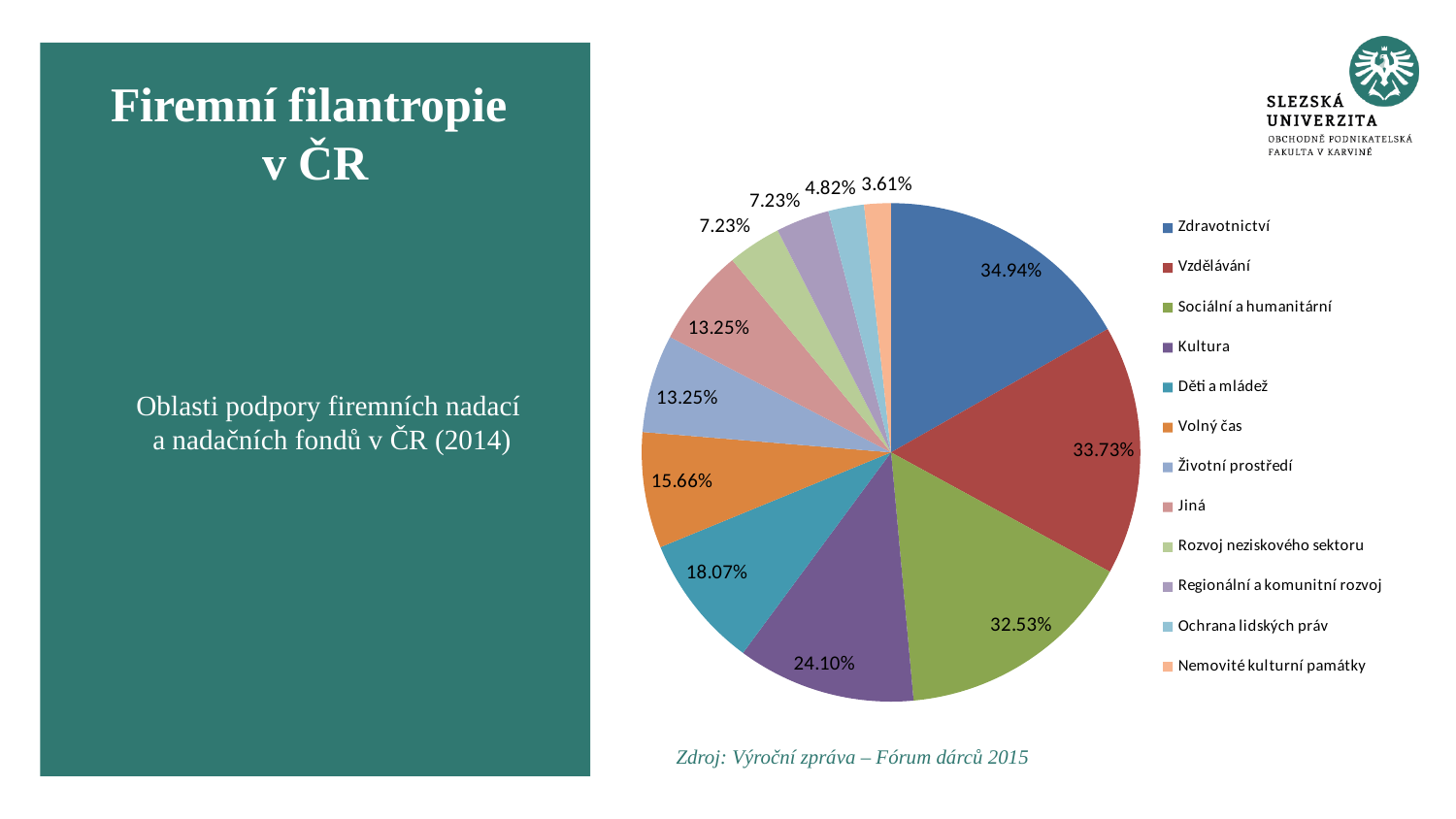
What is the value shown for Kultura? 24.10% What is the value shown for Děti a mládež? 18.07% Which is larger, the value for Sociální a humanitární or the value for Kultura? Sociální a humanitární What kind of chart is shown on the slide? pie chart Which category has the largest slice of the pie? Zdravotnictví What is the value shown for Nemovité kulturní památky? 3.61% What is the difference between the values for Zdravotnictví and Vzdělávání? 1.21% What is the difference between the values for Kultura and Volný čas? 8.44% How many categories does the legend list? 12 Which category has the smallest slice of the pie? Nemovité kulturní památky What source is cited below the chart? Výroční zpráva – Fórum dárců 2015 What is the value shown for Zdravotnictví? 34.94%